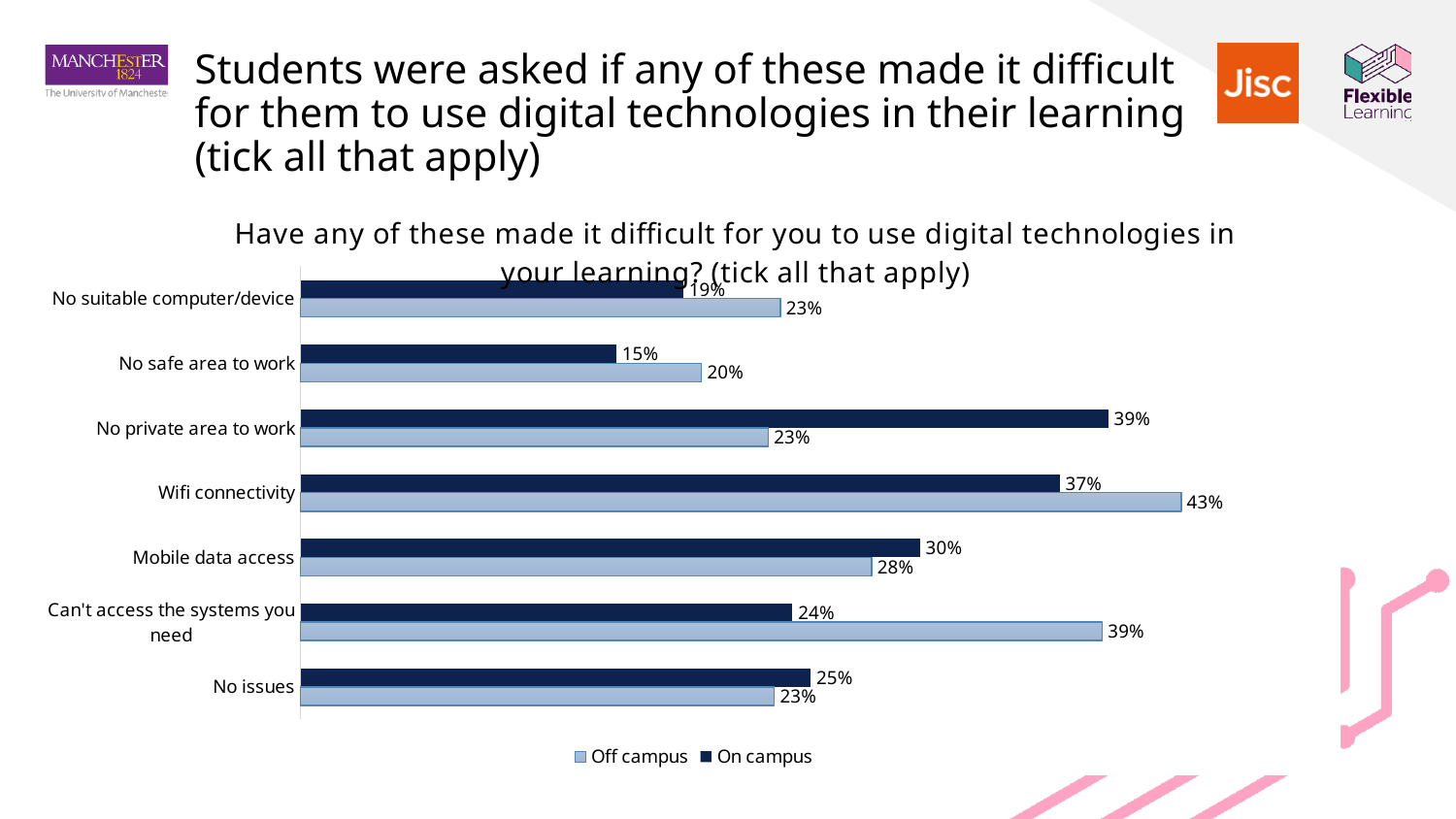
How many series does the legend list? 2 What is the difference between the on campus and off campus values for 'No private area to work'? 16% What is the difference between the off campus and on campus values for 'Can't access the systems you need'? 15% For 'Mobile data access', which is larger: the on campus value or the off campus value? On campus How many categories are shown on the chart? 7 What is the off campus value for 'Can't access the systems you need'? 39% Which category has the highest value for the Off campus series? Wifi connectivity What percentage of off campus students reported 'Wifi connectivity' as a difficulty? 43% What percentage of on campus students reported 'No private area to work' as a difficulty? 39% Which category has the lowest value for the On campus series? No safe area to work What type of chart is shown on the slide? Bar chart Which series is shown in dark navy bars? On campus